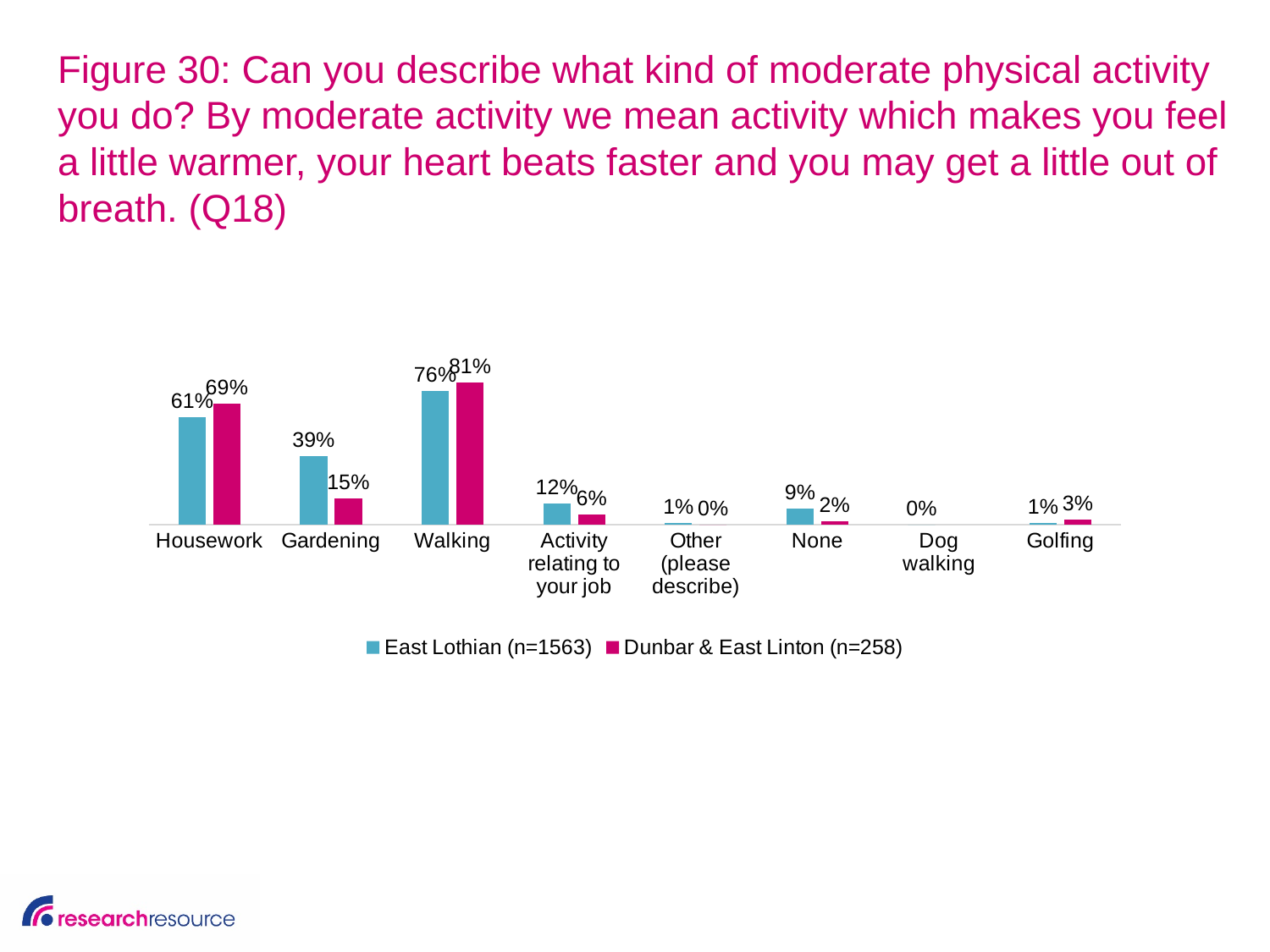
Which activity has the highest value for East Lothian? Walking How many series does the legend list? 2 What kind of chart is shown on the slide? Bar chart What is the value for Dunbar & East Linton for Golfing? 3% For Activity relating to your job, which series has the larger value, East Lothian or Dunbar & East Linton? East Lothian What is the difference between the East Lothian and Dunbar & East Linton values for Gardening? 24% What is the value for Dunbar & East Linton for Gardening? 15% Which activity has the highest value for Dunbar & East Linton? Walking How many activity categories are shown on the x axis? 8 What is the difference between the Dunbar & East Linton and East Lothian values for Housework? 8% What percentage of East Lothian respondents said they do walking as moderate physical activity? 76% What is the value for East Lothian for Housework? 61%